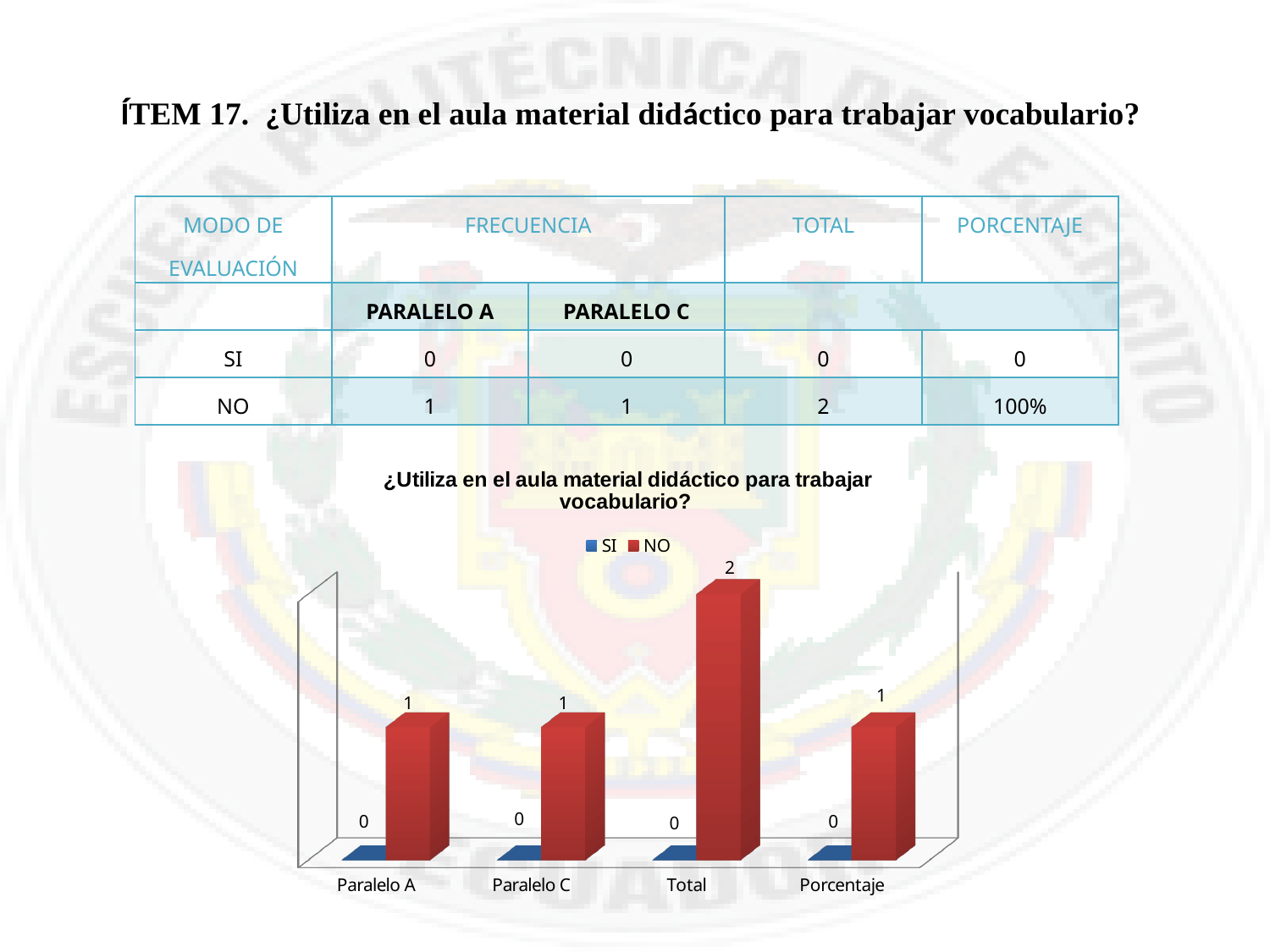
Which is larger for Paralelo C: the SI value or the NO value? NO Which colour represents the NO series in the chart? red What is the value of the NO series for Porcentaje? 1 What type of chart is shown on the slide? bar chart How many series does the chart legend list? 2 What is the title of the chart? ¿Utiliza en el aula material didáctico para trabajar vocabulario? What is the value of the SI series for Paralelo C? 0 What is the difference between the NO value for Total and the NO value for Paralelo A? 1 Which category has the highest value in the NO series? Total What is the value of the NO series for Paralelo A? 1 How many categories are shown along the x axis of the chart? 4 What is the value of the NO series for Total? 2